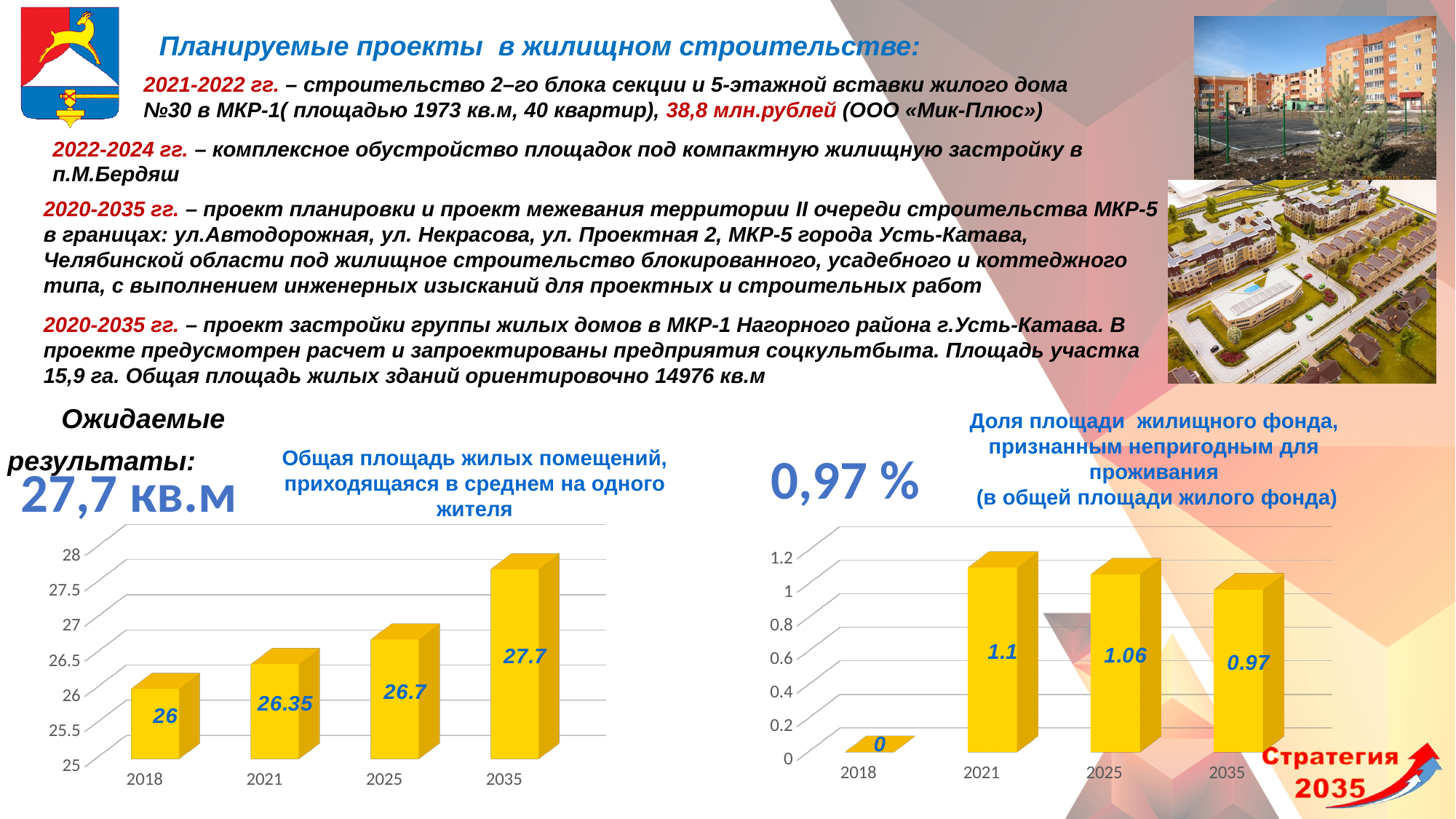
What type of chart is the right chart (Доля площади жилищного фонда, признанным непригодным для проживания)? bar chart In the right chart (Доля площади жилищного фонда, признанным непригодным для проживания), what is the value for 2018? 0 In the left chart (Общая площадь жилых помещений, приходящаяся в среднем на одного жителя), do the values rise or fall from 2018 to 2035? rise In the right chart (Доля площади жилищного фонда, признанным непригодным для проживания), what is the value for 2025? 1.06 How many years are shown on the x axis of the left chart (Общая площадь жилых помещений, приходящаяся в среднем на одного жителя)? 4 In the left chart (Общая площадь жилых помещений, приходящаяся в среднем на одного жителя), what is the value for 2035? 27.7 In the left chart (Общая площадь жилых помещений, приходящаяся в среднем на одного жителя), what is the difference between the values for 2035 and 2018? 1.7 In the right chart (Доля площади жилищного фонда, признанным непригодным для проживания), which is larger, the value for 2021 or the value for 2035? 2021 In the left chart (Общая площадь жилых помещений, приходящаяся в среднем на одного жителя), what is the value for 2021? 26.35 In the right chart (Доля площади жилищного фонда, признанным непригодным для проживания), what is the difference between the values for 2021 and 2035? 0.13 In the left chart (Общая площадь жилых помещений, приходящаяся в среднем на одного жителя), which year has the lowest value? 2018 In the right chart (Доля площади жилищного фонда, признанным непригодным для проживания), which year has the highest value? 2021